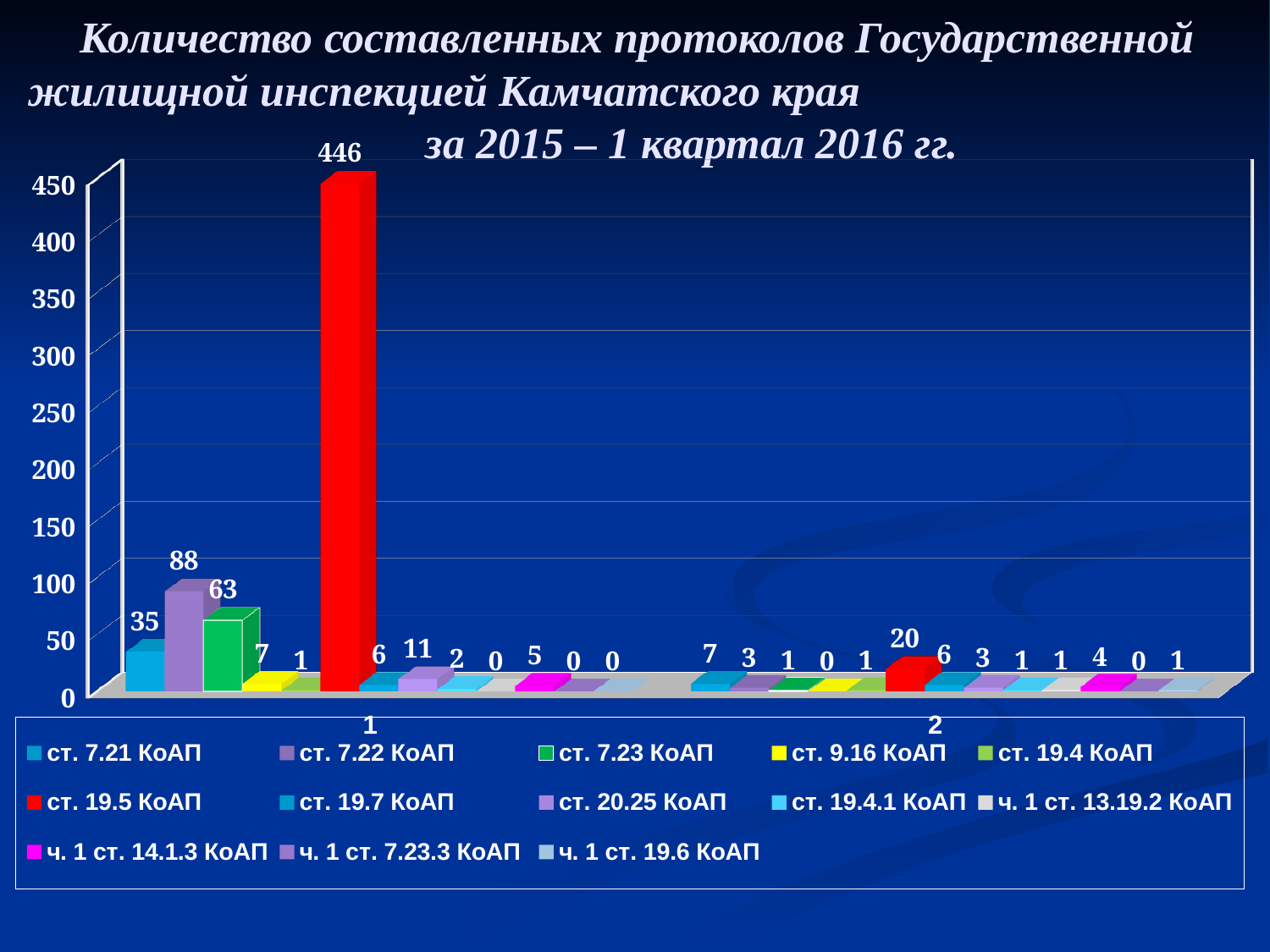
What is the value of the red bar (ст. 19.5 КоАП) in category 2? 20 What is the value of the first bar (ст. 7.21 КоАП) in category 1? 35 How many categories are shown on the x axis? 2 What is the difference between the ст. 7.22 КоАП value (88) and the ст. 7.21 КоАП value (35) in category 1? 53 Which series has the highest value in category 1? ст. 19.5 КоАП What is the value of the red bar (ст. 19.5 КоАП) in category 1? 446 Is the value of the red bar in category 1 greater or less than 400? greater How many series does the legend list? 13 Which series is shown in red in the legend? ст. 19.5 КоАП What is the difference between the ст. 19.5 КоАП values in category 1 and category 2? 426 What type of chart is shown on the slide? bar chart In category 1, which is larger: the ст. 7.22 КоАП bar (88) or the ст. 7.23 КоАП bar (63)? ст. 7.22 КоАП